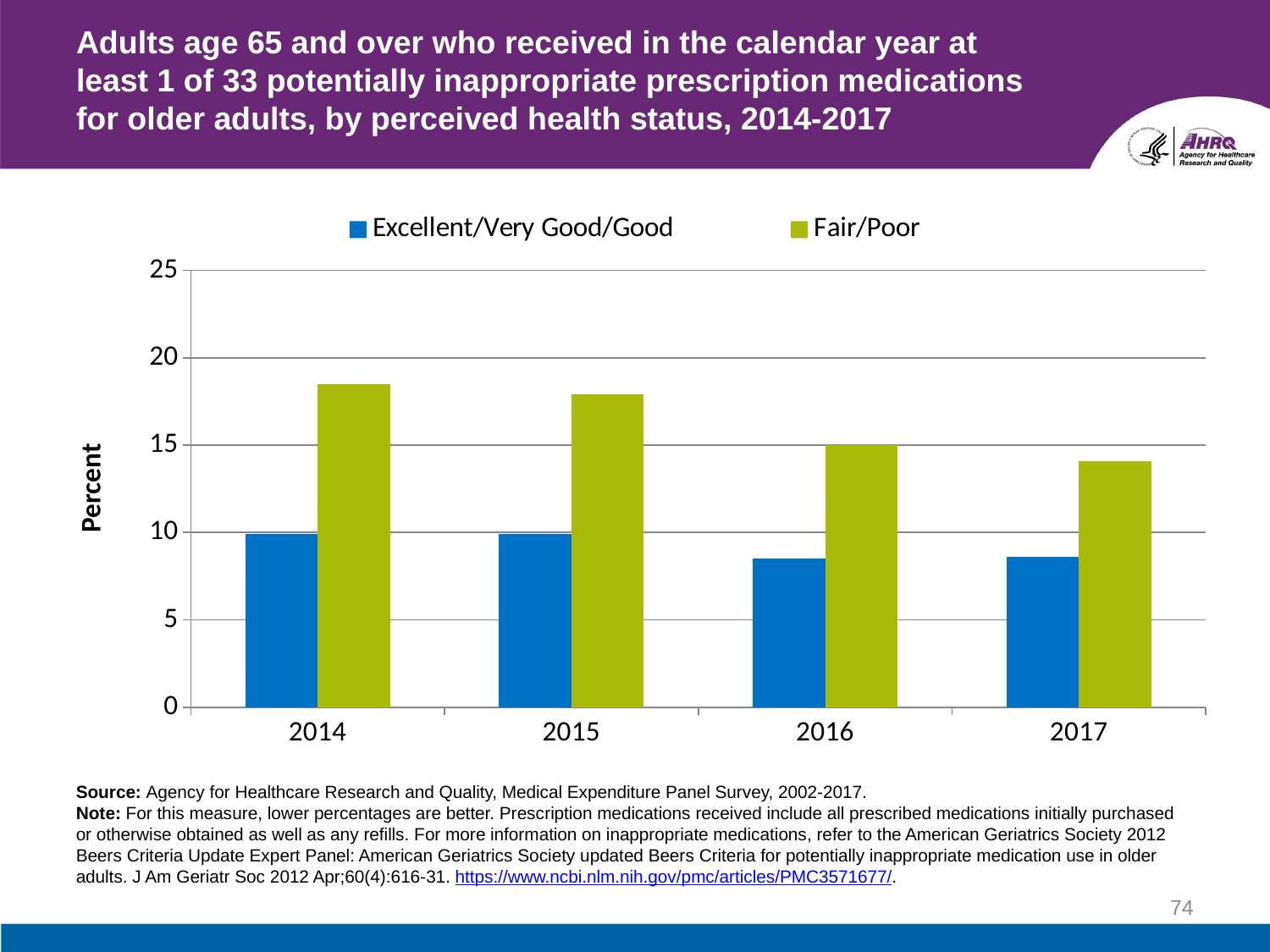
Is the value for Fair/Poor in 2014 greater or less than 15? greater Is the value for Fair/Poor in 2017 greater or less than 15? less Is the value for Fair/Poor in 2015 greater or less than 20? less Which year has the lowest value for Fair/Poor? 2017 What is the label on the vertical axis? Percent What kind of chart is shown on the slide? bar chart Do the Fair/Poor values rise or fall from 2014 to 2017? fall How many series does the legend list? 2 In 2016, which series has the larger value, Excellent/Very Good/Good or Fair/Poor? Fair/Poor How many years are shown on the x axis? 4 Which is larger, the Fair/Poor value in 2014 or the Fair/Poor value in 2017? 2014